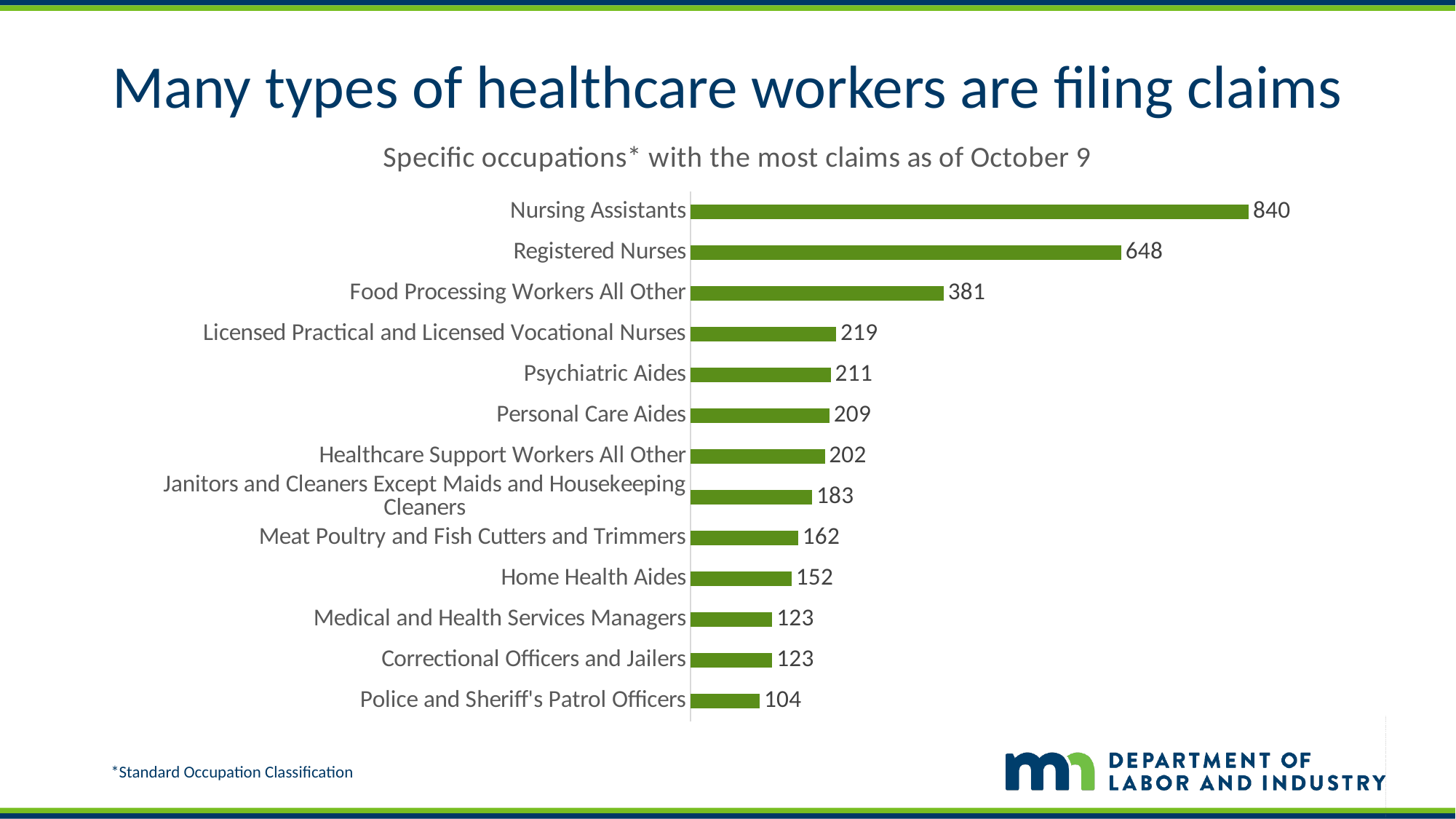
What is the value for Janitors and Cleaners Except Maids and Housekeeping Cleaners? 183 Which has more claims, Psychiatric Aides or Meat Poultry and Fish Cutters and Trimmers? Psychiatric Aides What is the difference between Food Processing Workers All Other and Licensed Practical and Licensed Vocational Nurses? 162 What is the difference in claims between Nursing Assistants and Registered Nurses? 192 What type of chart is shown on the slide? Bar chart Which occupation has the most claims? Nursing Assistants How many claims are shown for Nursing Assistants? 840 What is the subtitle of the chart? Specific occupations* with the most claims as of October 9 What is the value for Registered Nurses? 648 How many claims are shown for Home Health Aides? 152 Which occupation has the fewest claims? Police and Sheriff's Patrol Officers How many occupations are shown in the chart? 13